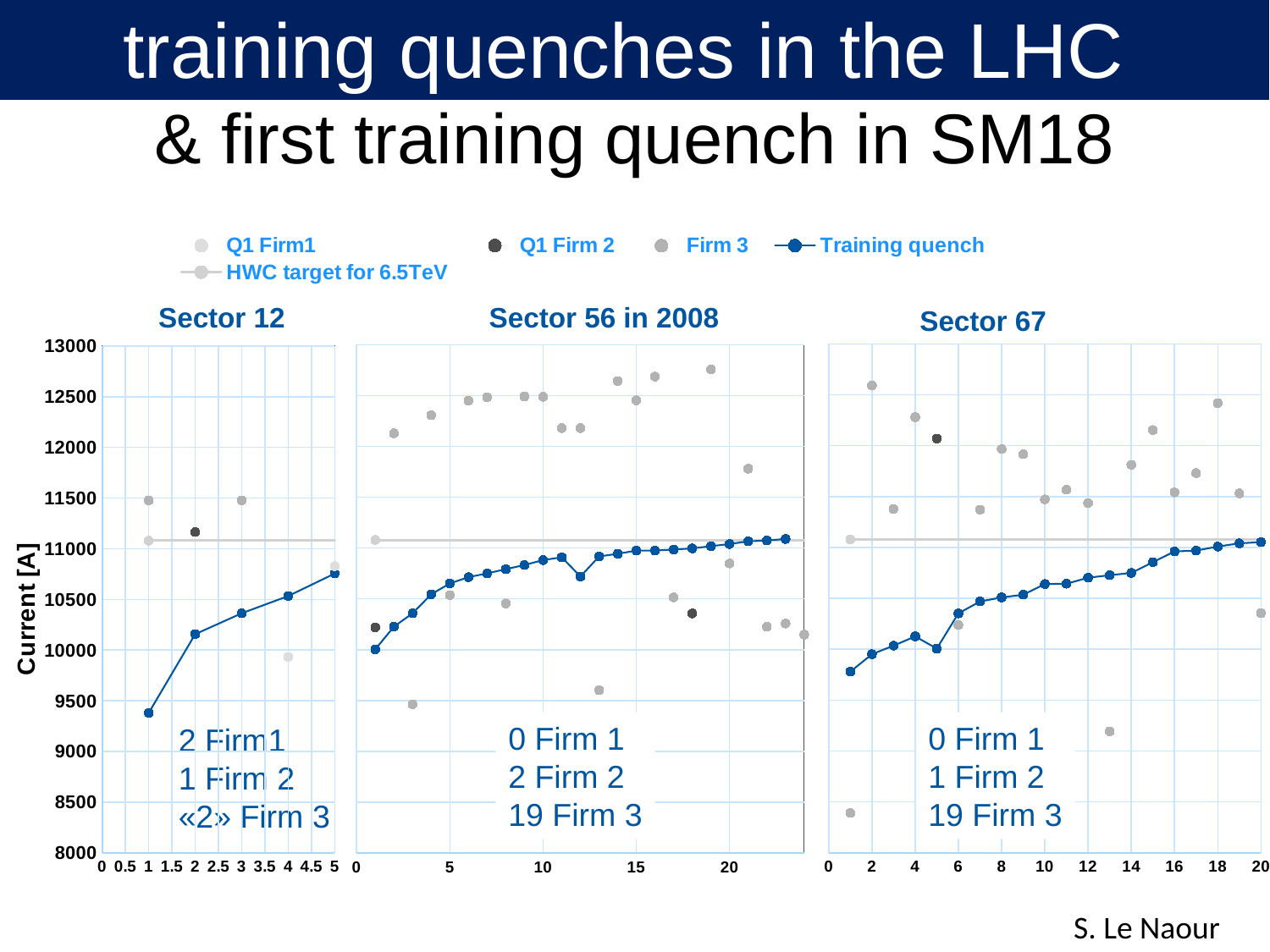
In the Sector 12 chart, is the Training quench value at x = 1 greater or less than 9500? less What is the label on the y axis shared by the three charts? Current [A] In the Sector 12 chart, which is larger: the Training quench value at x = 1 or at x = 5? x = 5 In the Sector 67 chart, how many points does the Training quench series have? 20 In the Sector 12 chart, how many points does the Training quench series have? 5 In the Sector 12 chart, does the Training quench series rise or fall along the x axis? rise What is the title of the middle chart? Sector 56 in 2008 In the Sector 56 in 2008 chart, is the Training quench value at x = 1 greater or less than 10500? less How many series does the legend list for the charts on this slide? 5 In the Sector 67 chart, does the Training quench series generally rise or fall along the x axis? rise In the Sector 67 chart, is the Training quench value at x = 1 greater or less than 10000? less In the Sector 12 chart, at which x value is the Training quench series lowest? 1